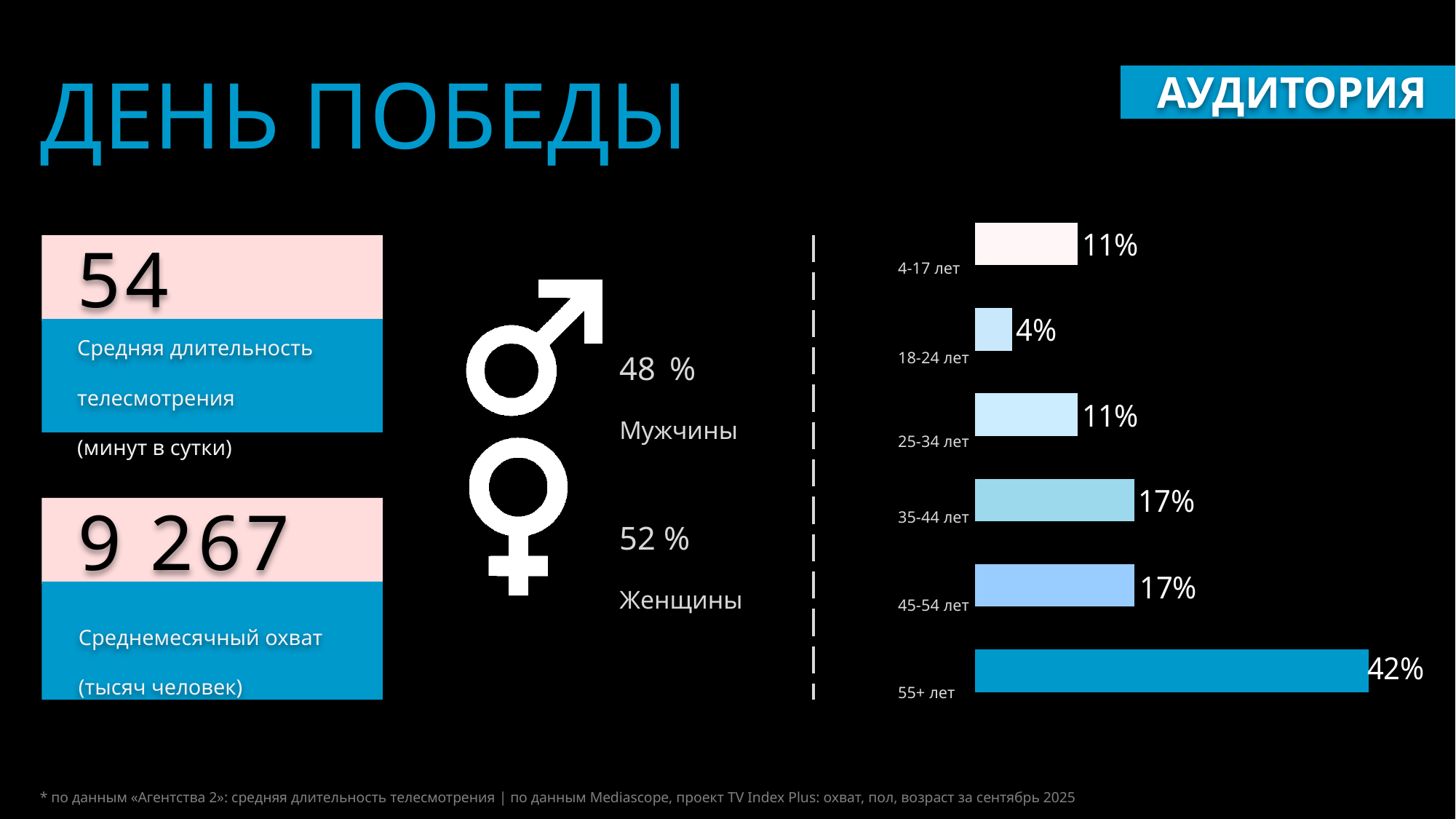
What type of chart is used to show the age groups? bar chart What is the difference between the values for 55+ лет and 45-54 лет in the bar chart? 25% What is the value for the 35-44 лет age group in the bar chart? 17% What is the value for the 18-24 лет age group in the bar chart? 4% Which is larger in the bar chart: the value for 35-44 лет or the value for 4-17 лет? 35-44 лет Do the values for 4-17 лет and 25-34 лет in the bar chart have the same value? Yes, both 11% What is the value for the 4-17 лет age group in the bar chart? 11% What is the value for the 55+ лет age group in the bar chart? 42% How many age groups are shown in the bar chart? 6 What is the difference between the values for 25-34 лет and 18-24 лет in the bar chart? 7% Which age group has the lowest value in the bar chart? 18-24 лет Which age group has the highest value in the bar chart? 55+ лет